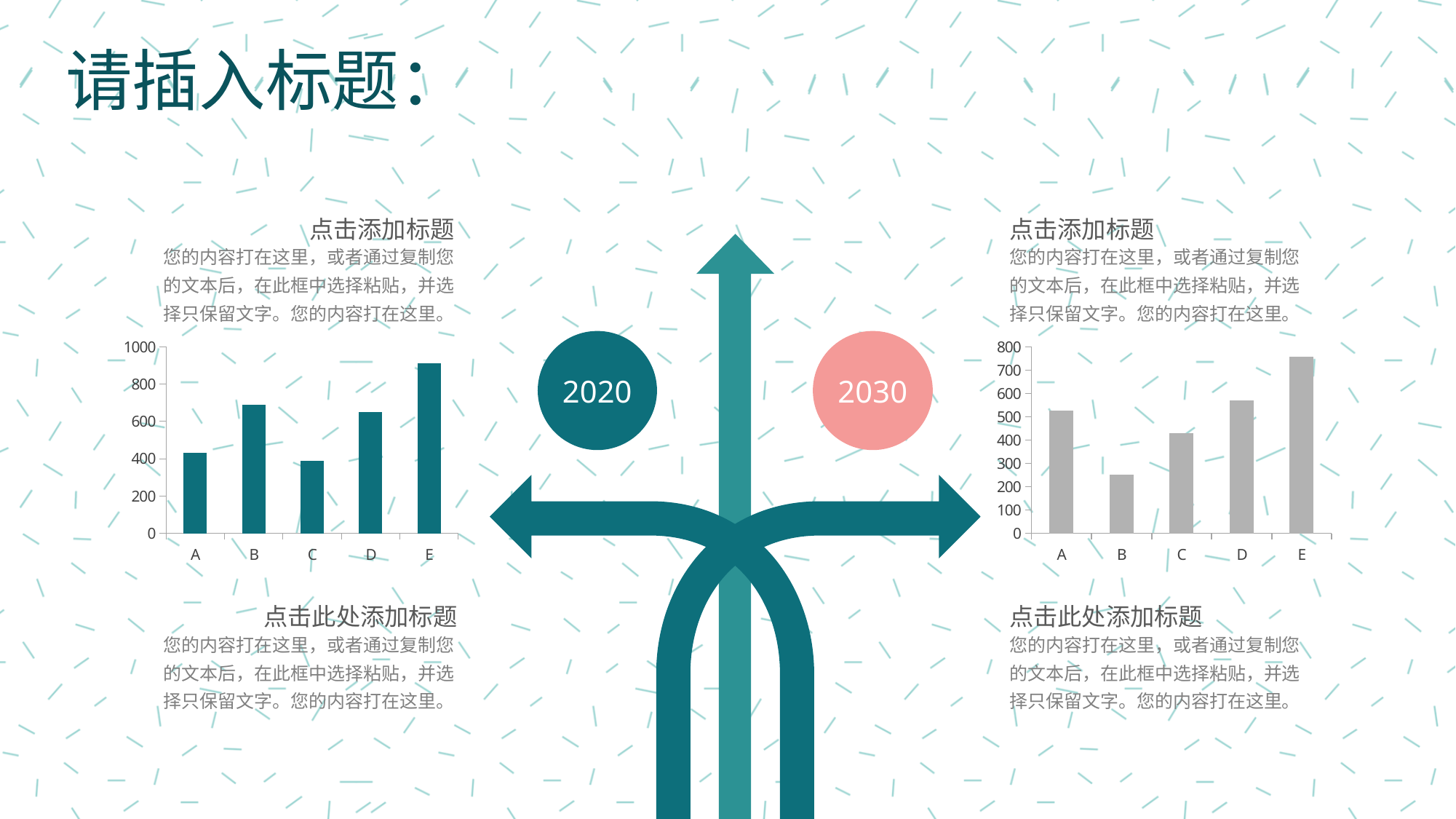
In the left chart, is the value for E greater or less than 800? greater In the right chart, is the value for E greater or less than 700? greater In the right chart, which is larger, the value for A or the value for C? A What is the highest value shown on the y axis of the right chart? 800 In the right chart, is the value for B greater or less than 300? less In the right chart, which category has the lowest bar? B How many categories are shown on the x axis of the left chart? 5 In the left chart, which category has the highest bar? E In the left chart, which is larger, the value for E or the value for A? E In the right chart, which category has the highest bar? E What kind of chart is the chart on the left side of the slide? bar chart